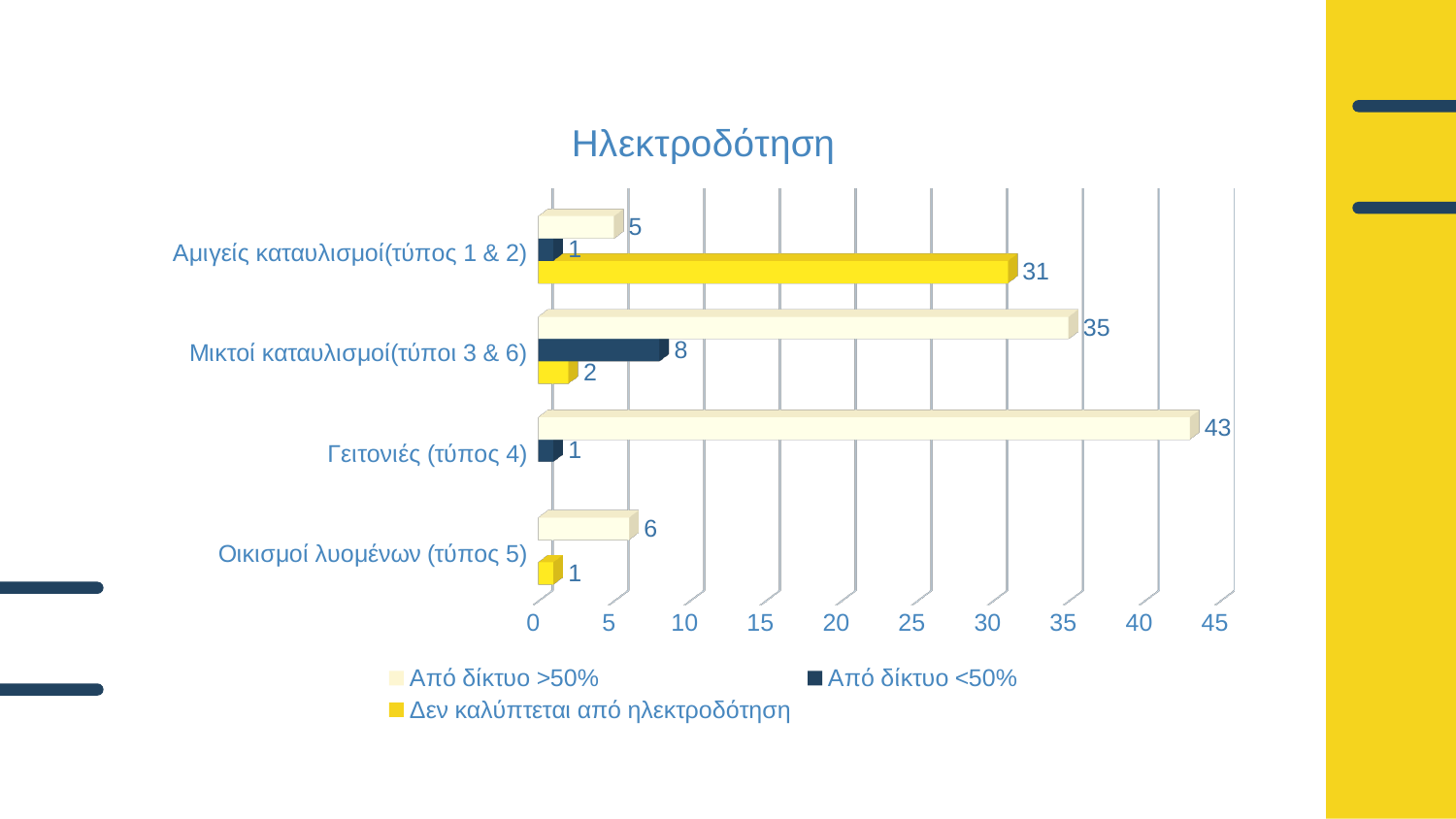
Which category has the lowest value for 'Από δίκτυο >50%'? Αμιγείς καταυλισμοί(τύπος 1 & 2) For Αμιγείς καταυλισμοί(τύπος 1 & 2), which is larger: 'Από δίκτυο >50%' or 'Δεν καλύπτεται από ηλεκτροδότηση'? Δεν καλύπτεται από ηλεκτροδότηση Which category has the highest value for 'Από δίκτυο >50%'? Γειτονιές (τύπος 4) How many categories are shown on the chart? 4 What is the value of 'Δεν καλύπτεται από ηλεκτροδότηση' for Αμιγείς καταυλισμοί(τύπος 1 & 2)? 31 What is the value of 'Από δίκτυο <50%' for Μικτοί καταυλισμοί(τύποι 3 & 6)? 8 What is the difference between the 'Από δίκτυο >50%' values for Γειτονιές (τύπος 4) and Μικτοί καταυλισμοί(τύποι 3 & 6)? 8 What type of chart is shown on the slide? bar chart What is the title of the chart? Ηλεκτροδότηση What is the value of 'Από δίκτυο >50%' for Οικισμοί λυομένων (τύπος 5)? 6 How many series does the legend list? 3 What is the value of 'Από δίκτυο >50%' for Γειτονιές (τύπος 4)? 43